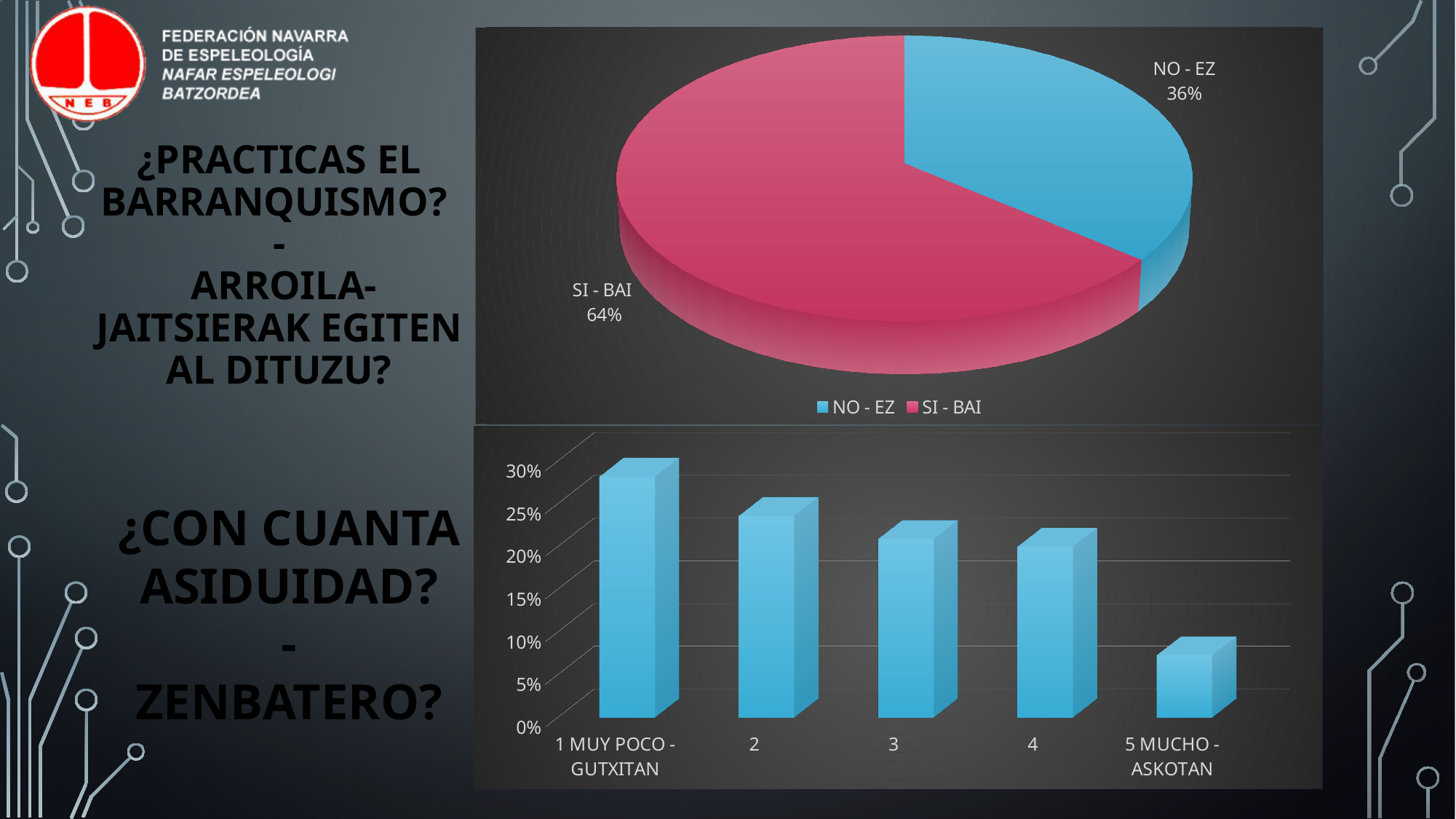
What kind of chart is the bottom chart on the slide? bar chart In the bottom bar chart, do the bar values generally rise or fall from left to right along the x axis? fall How many entries does the legend of the top pie chart list? 2 In the top pie chart, which slice is the largest? SI - BAI In the bottom bar chart, which category has the highest bar? 1 MUY POCO - GUTXITAN How many categories are shown on the x axis of the bottom bar chart? 5 What kind of chart is the top chart on the slide? pie chart In the top pie chart, what percentage is shown for NO - EZ? 36% In the top pie chart, what is the difference in percentage points between SI - BAI and NO - EZ? 28 In the top pie chart, what percentage is shown for SI - BAI? 64% In the bottom bar chart, which category has the lowest bar? 5 MUCHO - ASKOTAN In the bottom bar chart, is the value for 5 MUCHO - ASKOTAN greater or less than 10%? less